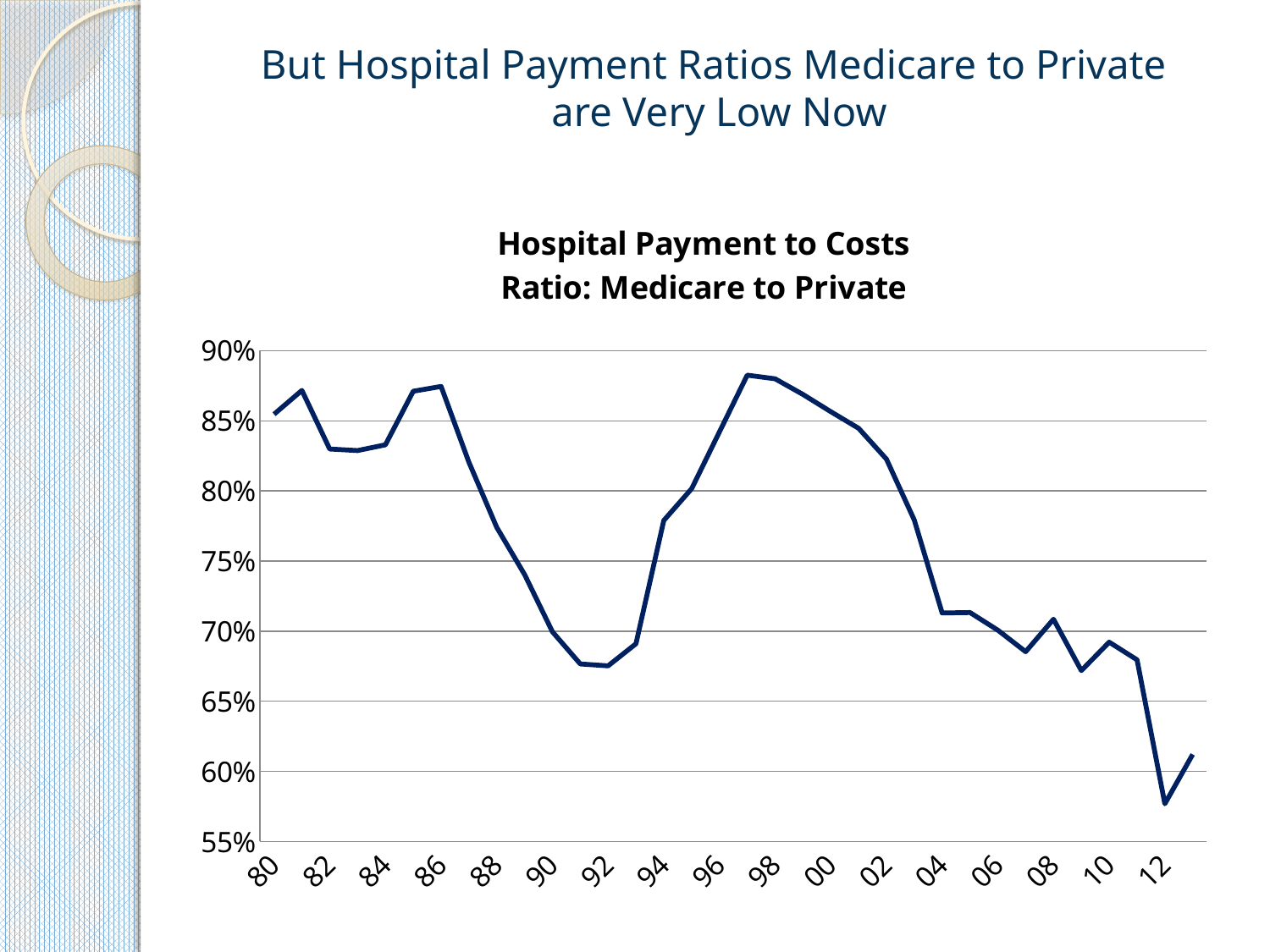
Which year label on the x axis has the lowest value? 12 How many year labels are shown along the x axis? 17 Is the value for 92 greater or less than 70%? less What is the title of the chart? Hospital Payment to Costs Ratio: Medicare to Private Is the value for 98 greater or less than 85%? greater Which is larger, the value for 86 or the value for 92? 86 Is the value for 12 greater or less than 60%? less What kind of chart is shown on the slide? Line chart Which is larger, the value for 98 or the value for 04? 98 Overall, does the line rise or fall from 80 to 12? Fall